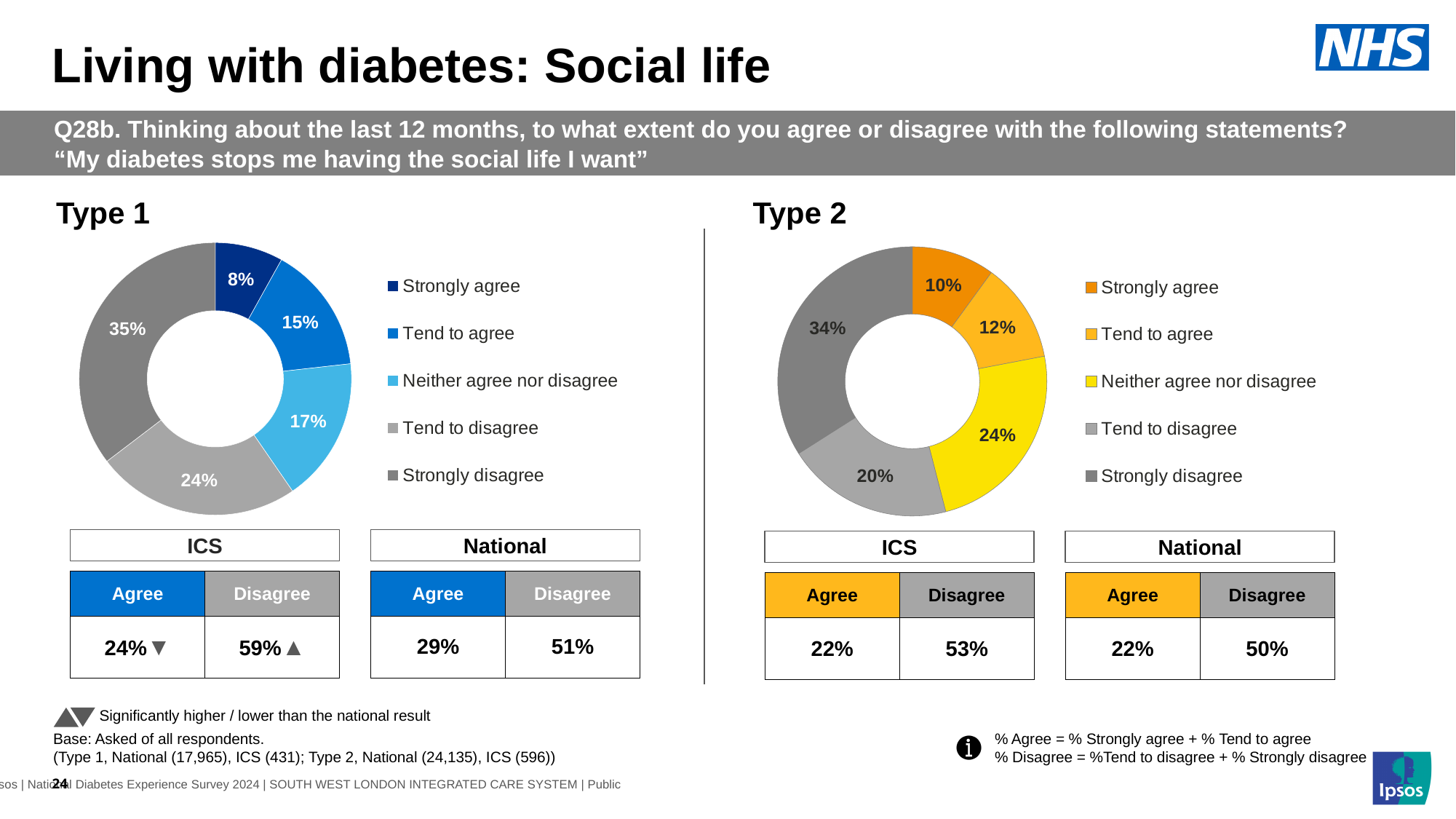
What kind of chart is used for Type 1? Donut chart In the Type 2 chart, which is larger: the Neither agree nor disagree share or the Tend to disagree share? Neither agree nor disagree In the Type 2 chart, which response category has the smallest share? Strongly agree In the Type 2 chart, which response category has the largest share? Strongly disagree In the Type 1 chart, which response category has the smallest share? Strongly agree In the Type 2 chart, what is the difference between the Strongly disagree and Tend to disagree shares? 14% In the Type 2 chart, what colour is the Strongly agree segment? Orange In the Type 1 chart, what is the difference between the Tend to disagree and Tend to agree shares? 9% In the Type 1 chart, what percentage of respondents said they strongly disagree? 35% How many response categories does the legend of the Type 1 chart list? 5 In the Type 2 chart, what percentage of respondents said they neither agree nor disagree? 24% In the Type 1 chart, what percentage of respondents said they tend to agree? 15%